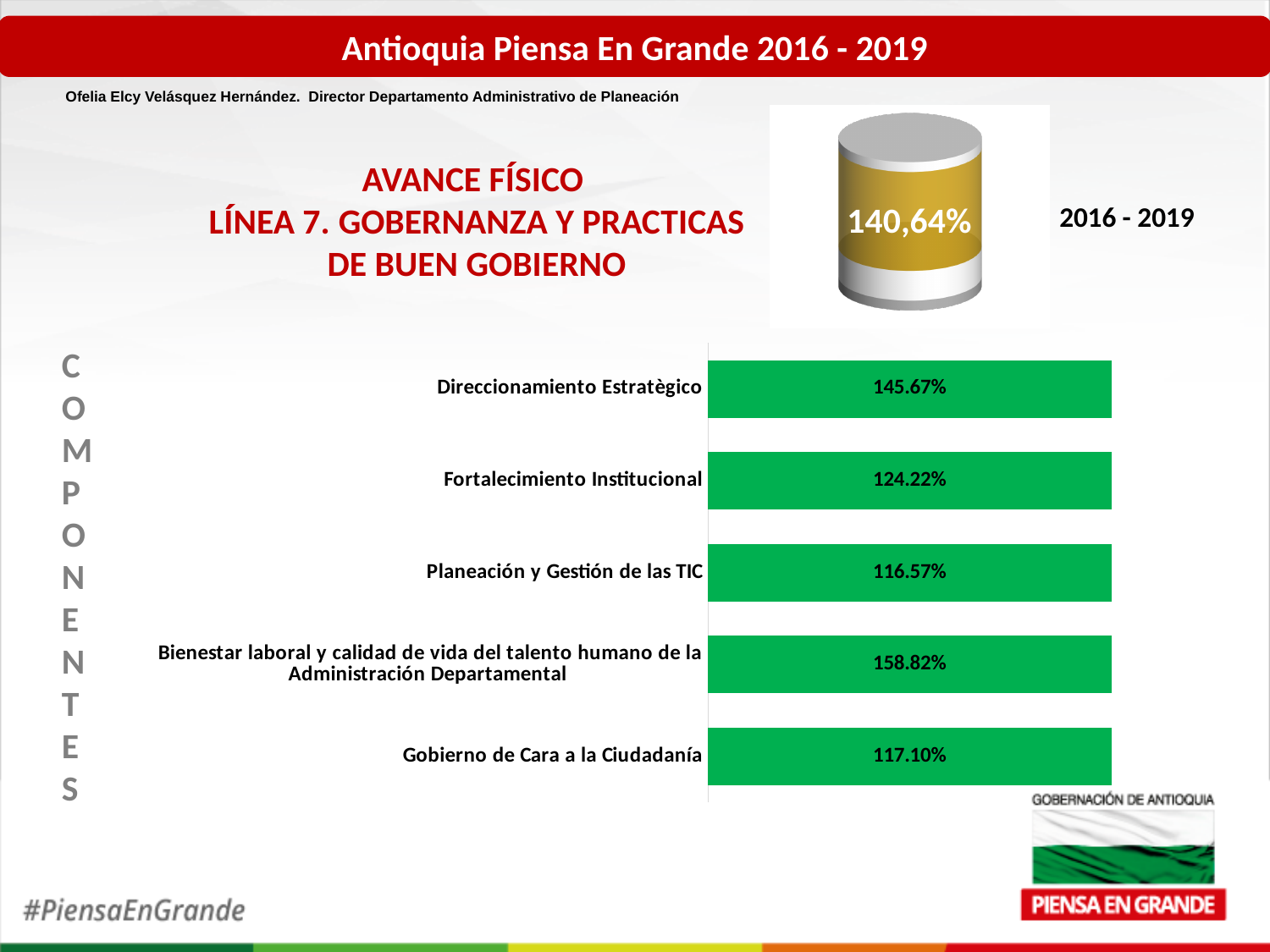
What colour are the bars in the chart? green What kind of chart is shown on the slide? bar chart How many components are shown in the bar chart? 5 What is the value for Fortalecimiento Institucional? 124.22% What is the value for Direccionamiento Estratègico? 145.67% Which is larger, the value for Gobierno de Cara a la Ciudadanía or the value for Planeación y Gestión de las TIC? Gobierno de Cara a la Ciudadanía What is the value for Bienestar laboral y calidad de vida del talento humano de la Administración Departamental? 158.82% What is the value for Planeación y Gestión de las TIC? 116.57% Which component has the highest value? Bienestar laboral y calidad de vida del talento humano de la Administración Departamental What is the value for Gobierno de Cara a la Ciudadanía? 117.10% Which component has the lowest value? Planeación y Gestión de las TIC What is the difference between the values for Direccionamiento Estratègico and Fortalecimiento Institucional? 21.45%